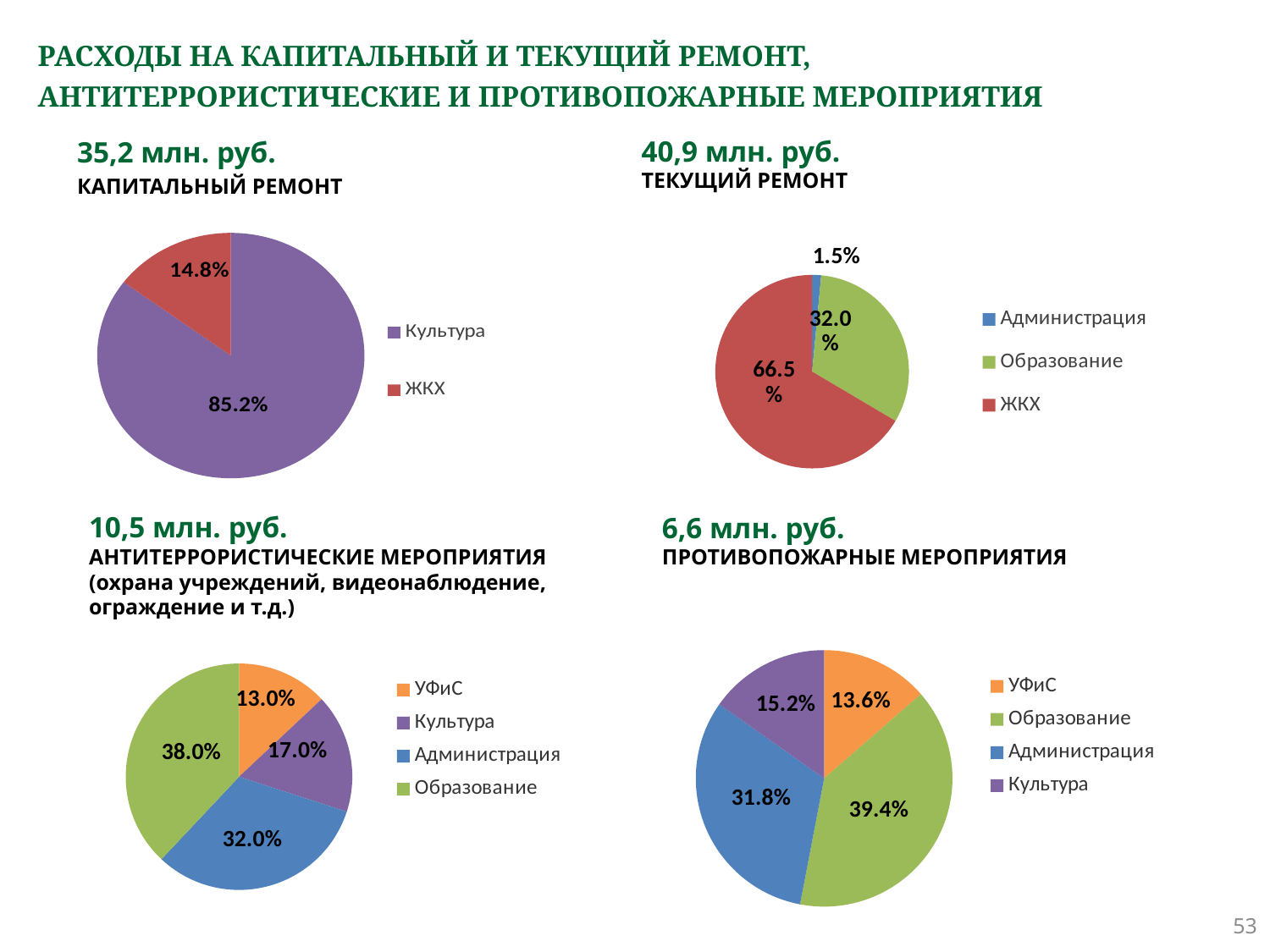
What type of chart is used for ТЕКУЩИЙ РЕМОНТ? Pie chart In the АНТИТЕРРОРИСТИЧЕСКИЕ МЕРОПРИЯТИЯ pie chart, which category has the smallest share? УФиС In the ТЕКУЩИЙ РЕМОНТ pie chart, which category has the largest share? ЖКХ In the КАПИТАЛЬНЫЙ РЕМОНТ pie chart, what share does ЖКХ have? 14.8% In the ПРОТИВОПОЖАРНЫЕ МЕРОПРИЯТИЯ pie chart, what share does Администрация have? 31.8% In the ТЕКУЩИЙ РЕМОНТ pie chart, how many categories does the legend list? 3 In the ПРОТИВОПОЖАРНЫЕ МЕРОПРИЯТИЯ pie chart, how many categories are shown? 4 In the ТЕКУЩИЙ РЕМОНТ pie chart, what share does Администрация have? 1.5% In the АНТИТЕРРОРИСТИЧЕСКИЕ МЕРОПРИЯТИЯ pie chart, what is the difference between the shares of Администрация and Культура? 15.0% In the ПРОТИВОПОЖАРНЫЕ МЕРОПРИЯТИЯ pie chart, which is larger: the share of Культура or the share of УФиС? Культура